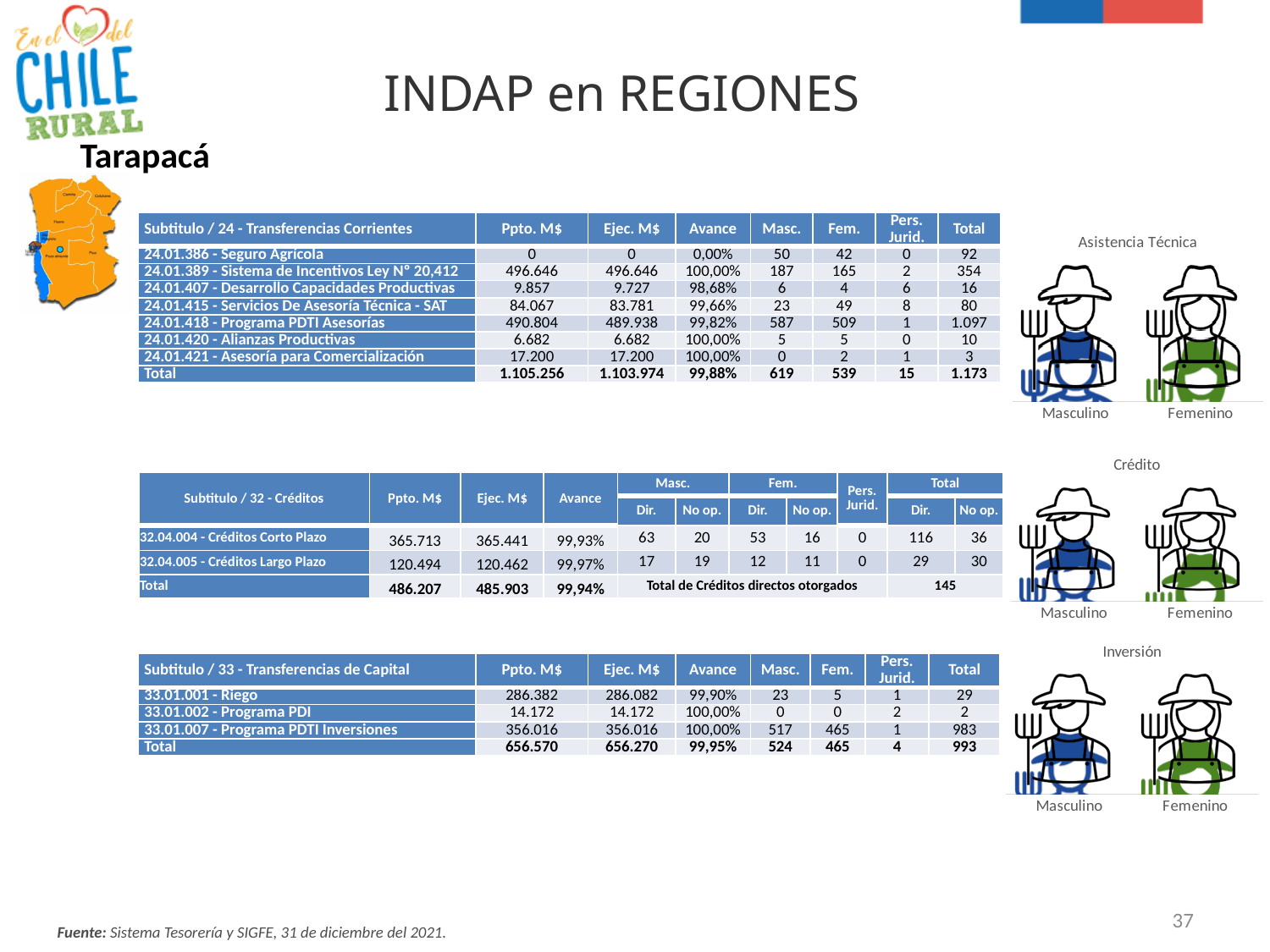
In the Crédito chart, what are the two categories shown? Masculino and Femenino In the Crédito chart, which category has the larger filled share, Masculino or Femenino? Masculino What is the title of the pictogram chart at the bottom right of the slide? Inversión What type of chart is used to show the Masculino and Femenino breakdown next to each table? pictogram (filled farmer icons) In the Inversión chart, how many categories are shown? 2 In the Asistencia Técnica chart, how many categories are shown? 2